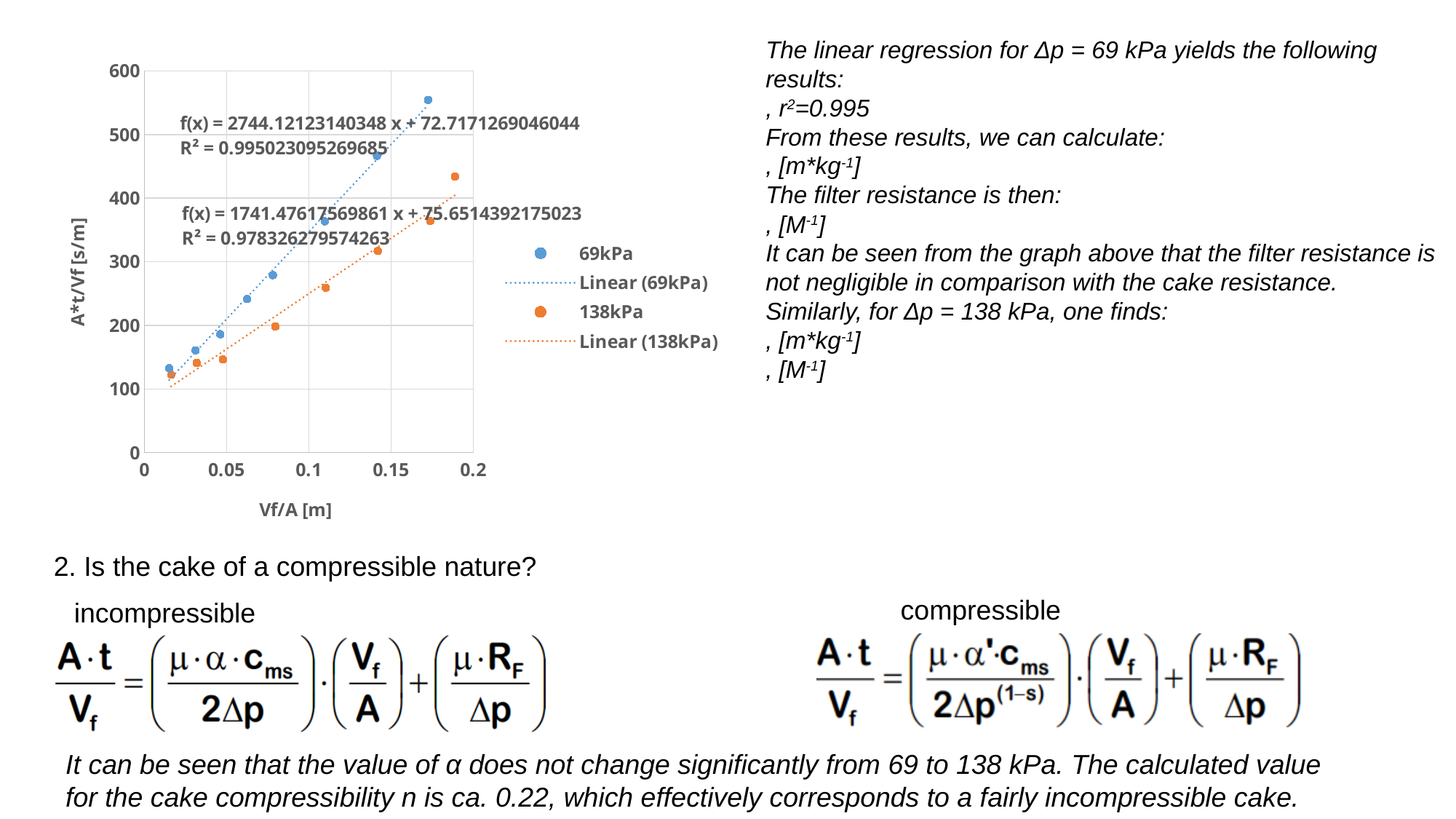
What kind of chart is shown on the slide? scatter chart Is the highest plotted value of the 138kPa series greater or less than 500? less Is the highest plotted value of the 69kPa series greater or less than 500? greater Do the plotted values of the 69kPa series rise or fall as Vf/A increases? rise How many entries does the chart legend list? 4 What R² value is printed for the 69kPa trendline? 0.995023095269685 What R² value is printed for the 138kPa trendline? 0.978326279574263 What is the label of the x axis of the chart? Vf/A [m] What is the intercept of the fitted line f(x) for the 138kPa series? 75.6514392175023 What is the label of the y axis of the chart? A*t/Vf [s/m] What is the slope of the fitted line f(x) for the 69kPa series? 2744.12123140348 Which series has the higher R² value, 69kPa or 138kPa? 69kPa